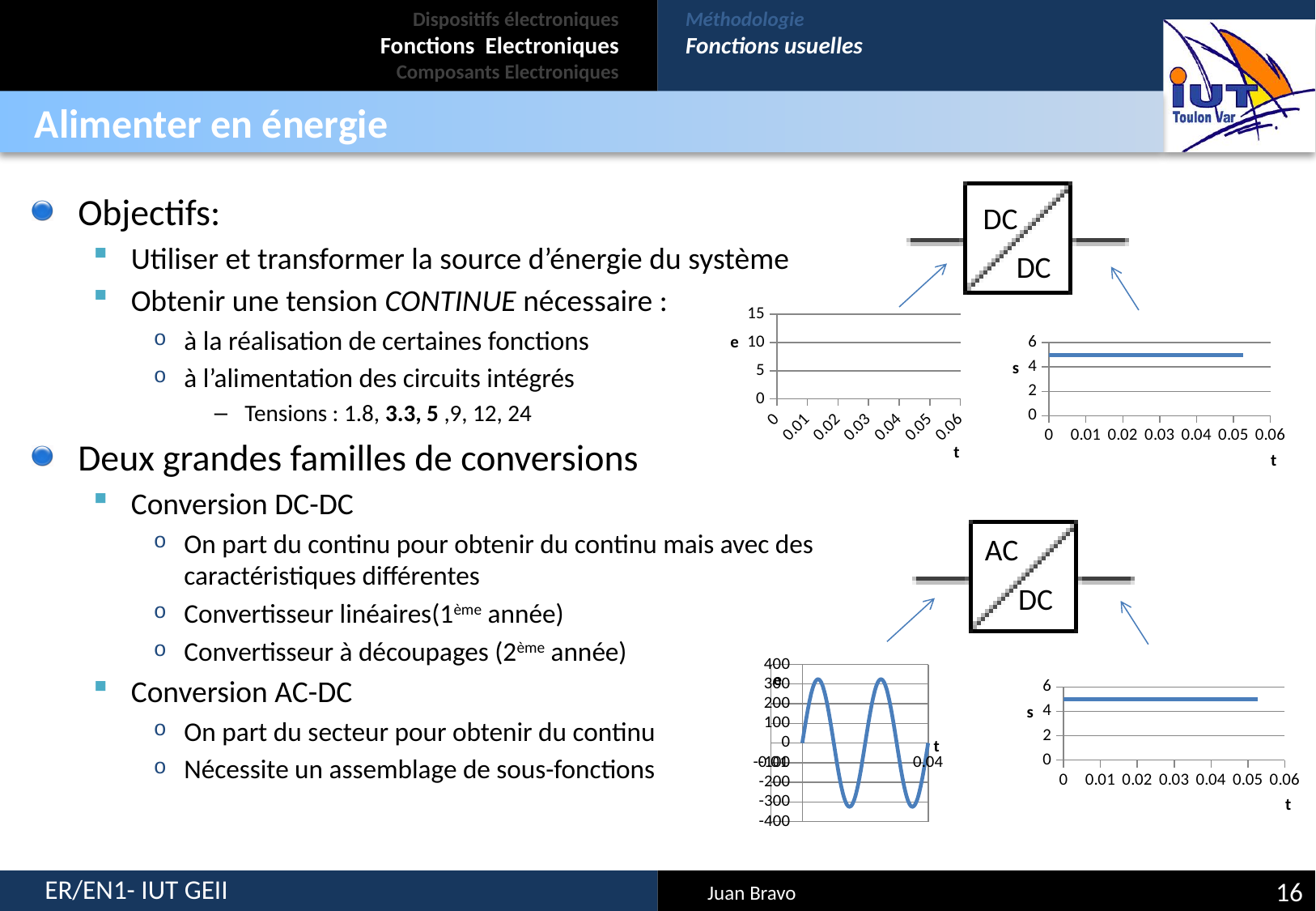
In the top-right chart (labelled s, next to the DC/DC block), is the plotted value greater or less than 6? less In the bottom-left chart (labelled e, below the AC/DC block), does the curve rise steadily, fall steadily, or oscillate along the t axis? oscillate In the top-right chart (labelled s, next to the DC/DC block), is the plotted value greater or less than 4? greater In the bottom-left chart (labelled e, below the AC/DC block), is the peak value of the curve greater or less than 300? greater In the top-left chart (labelled e, next to the DC/DC block), what is the highest value shown on the vertical axis? 15 How many charts are shown on the slide? 4 In the bottom-right chart (labelled s, next to the AC/DC block), what is the last tick value shown on the horizontal t axis? 0.06 In the bottom-left chart (labelled e, below the AC/DC block), what is the lowest value shown on the vertical axis? -400 In the bottom-left chart (labelled e, below the AC/DC block), what is the highest value shown on the vertical axis? 400 What kind of chart is the bottom-left chart (labelled e, below the AC/DC block)? line chart In the top-right chart (labelled s, next to the DC/DC block), does the plotted line rise, fall, or stay constant along the t axis? stay constant